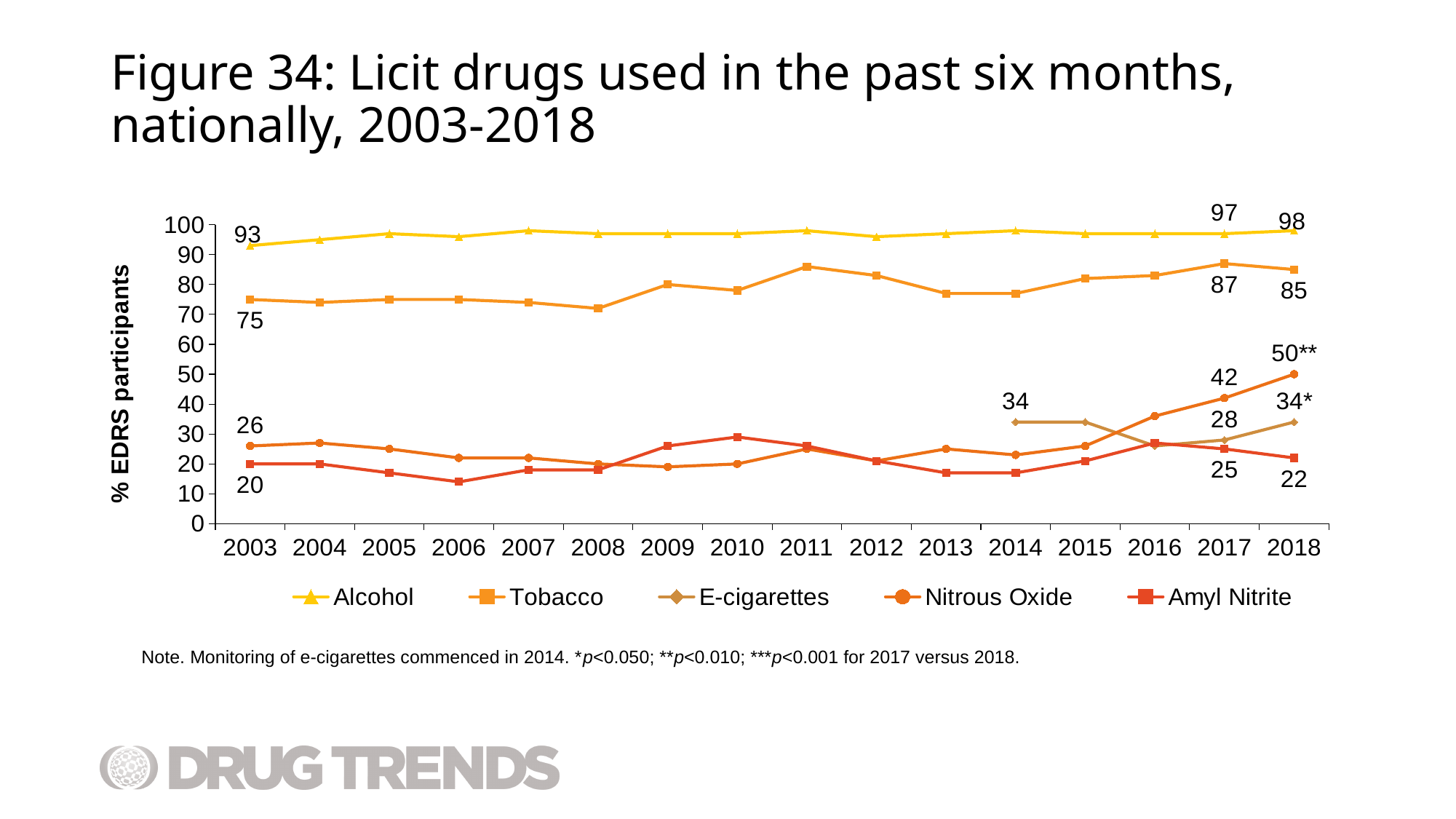
What kind of chart is shown on the slide? Line chart Which series had the highest value in 2018? Alcohol What was the value for Amyl Nitrite in 2017? 25 Is the value for Tobacco in 2011 greater or less than 80? greater By how many percentage points did Nitrous Oxide use change from 2017 to 2018? 8 What was the value for E-cigarettes in 2014? 34 What was the value for Nitrous Oxide in 2018? 50** What is the difference between the Alcohol and Tobacco values in 2018? 13 Which series had the lowest value in 2018? Amyl Nitrite How many series does the legend list? 5 What was the percentage of EDRS participants reporting alcohol use in 2018? 98 What was the value for Tobacco in 2003? 75